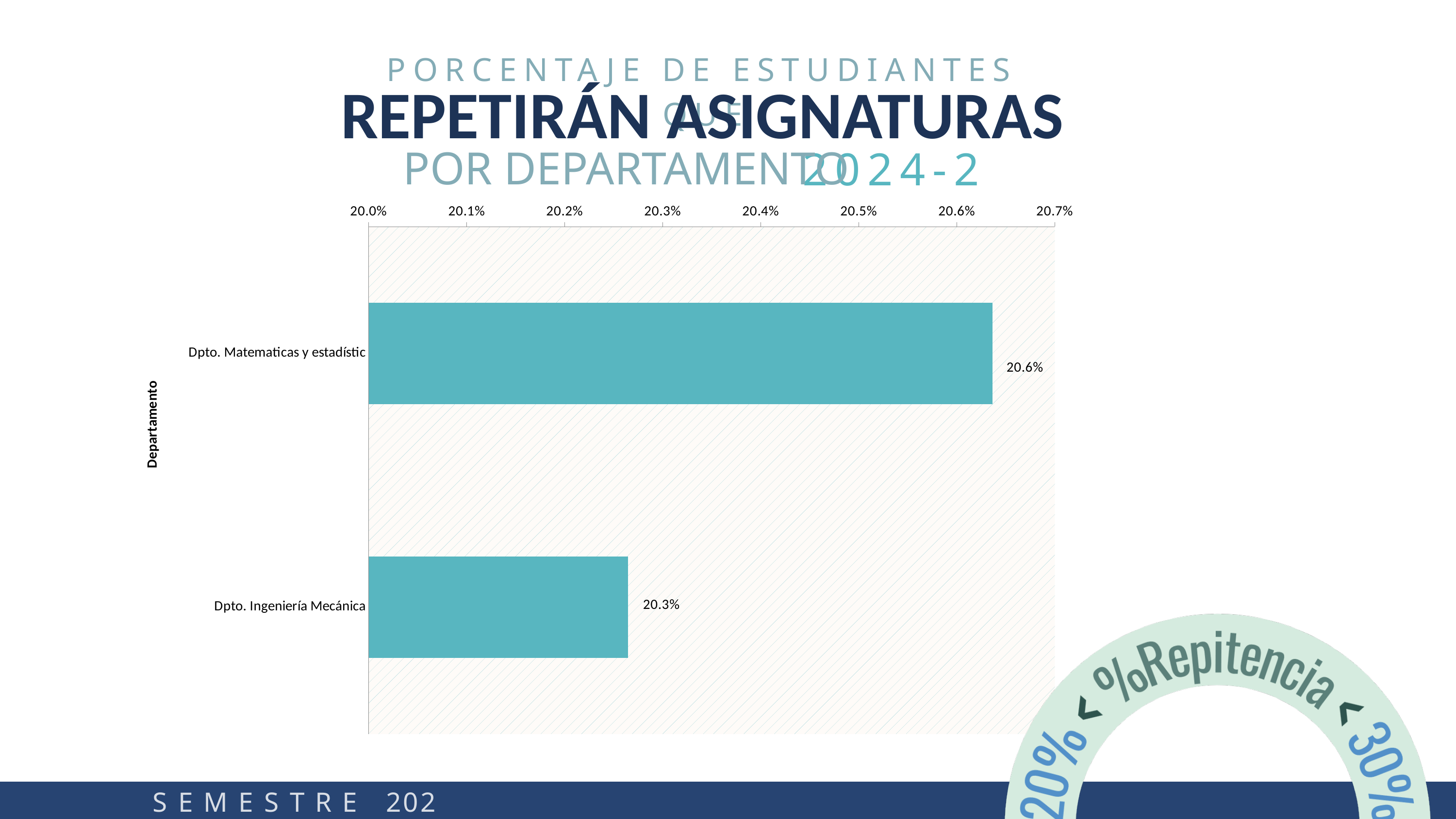
What is the value for Dpto. Matematicas y estadístic? 20.6% Is the value for Dpto. Matematicas y estadístic greater or less than 20.5%? greater Is the value for Dpto. Ingeniería Mecánica greater or less than 20.4%? less What is the title of the vertical axis of the chart? Departamento What kind of chart is shown on the slide? bar chart How many departments are shown in the chart? 2 Which department has the highest percentage? Dpto. Matematicas y estadístic What is the value for Dpto. Ingeniería Mecánica? 20.3% What is the difference between the values for Dpto. Matematicas y estadístic and Dpto. Ingeniería Mecánica? 0.3% Which department has the lowest percentage? Dpto. Ingeniería Mecánica What is the highest value shown on the horizontal axis of the chart? 20.7% Which is larger, the value for Dpto. Ingeniería Mecánica or the value for Dpto. Matematicas y estadístic? Dpto. Matematicas y estadístic